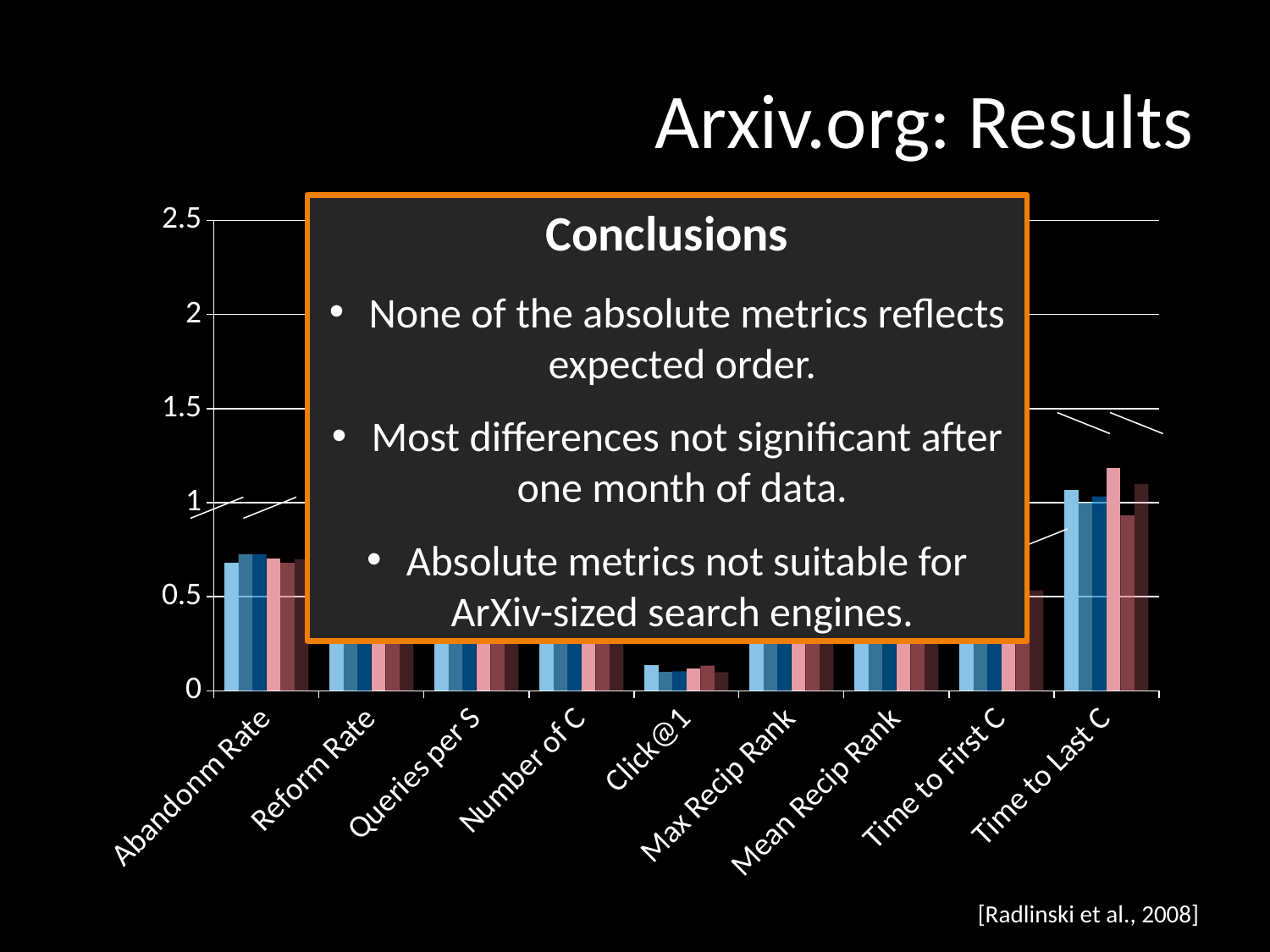
Are the values for Time to Last C greater or less than 0.5? greater Which category has the lowest bars in the chart? Click@1 Which category has larger values, Click@1 or Time to Last C? Time to Last C Which category has larger values, Abandonm Rate or Click@1? Abandonm Rate Are the values for Abandonm Rate greater or less than 0.5? greater Are the values for Click@1 greater or less than 0.5? less What is the title of the slide containing the chart? Arxiv.org: Results How many categories are shown along the x axis of the chart? 9 What kind of chart is shown on the slide? bar chart What is the highest value shown on the y axis of the chart? 2.5 How many bars are plotted for each category in the chart? 6